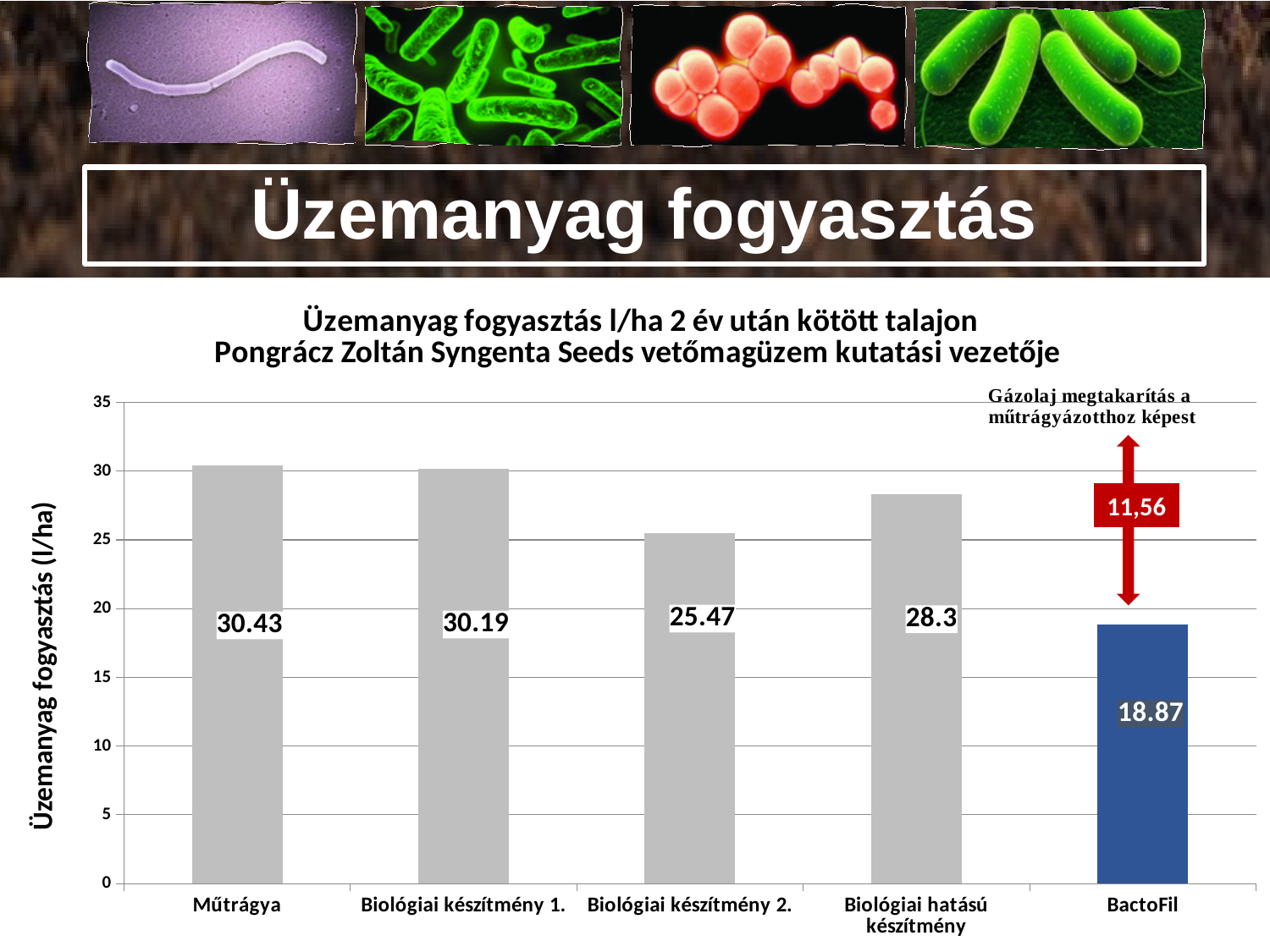
Is the value for Biológiai készítmény 1. greater or less than 25? greater What is the difference between the values for Műtrágya and BactoFil? 11.56 What kind of chart is shown on the slide? bar chart What is the value shown for Biológiai készítmény 2.? 25.47 Which has a higher value, Biológiai készítmény 2. or Biológiai hatású készítmény? Biológiai hatású készítmény Which category has the lowest fuel consumption? BactoFil How many categories are shown on the x axis? 5 Which category has the highest fuel consumption? Műtrágya What is the fuel consumption value for Műtrágya? 30.43 What is the fuel consumption value for BactoFil? 18.87 What is the label of the y axis? Üzemanyag fogyasztás (l/ha) What is the value shown for Biológiai hatású készítmény? 28.3